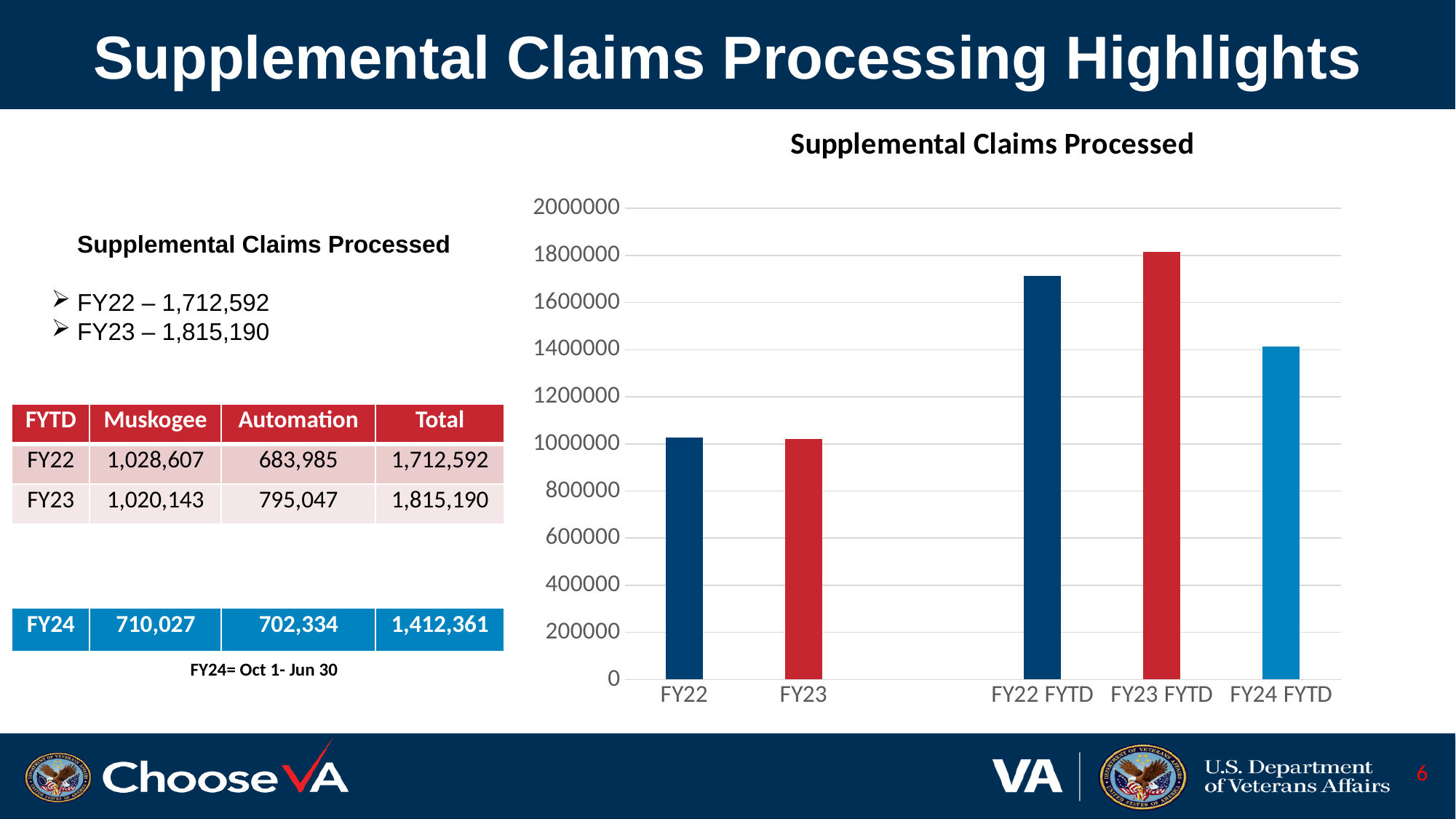
Is the value for FY22 greater or less than 1200000? less Which is larger in the chart, FY24 FYTD or FY22 FYTD? FY22 FYTD What kind of chart is shown on the slide? bar chart Is the value for FY22 FYTD greater or less than 1600000? greater Which category has the highest bar in the chart? FY23 FYTD How many bars are plotted in the chart? 5 Is the value for FY24 FYTD greater or less than 1600000? less Which is larger in the chart, FY22 FYTD or FY23 FYTD? FY23 FYTD What colour is the FY23 FYTD bar in the chart? red What is the title of the chart? Supplemental Claims Processed